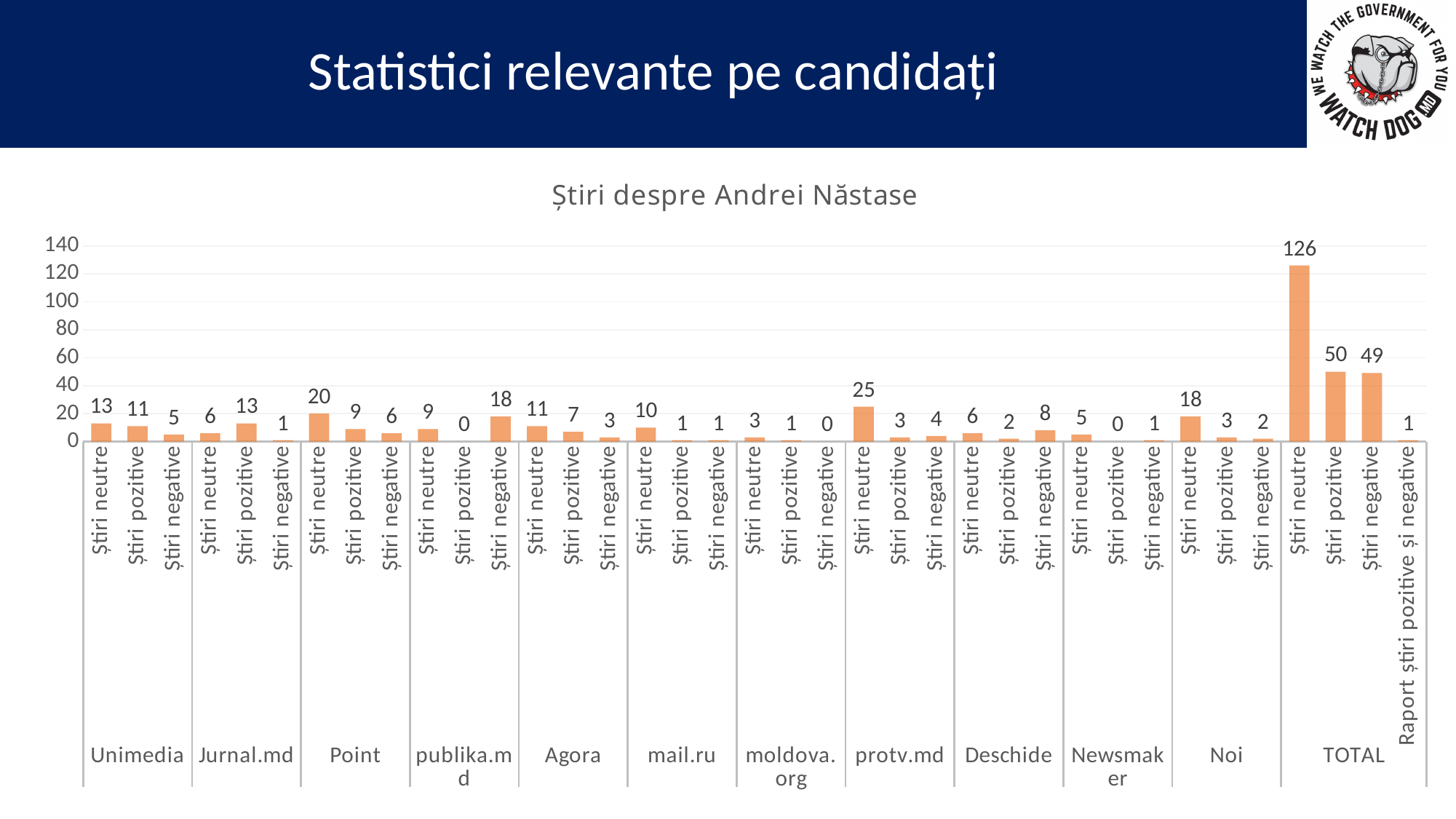
What is the value of Știri neutre for protv.md? 25 What is the title of the chart? Știri despre Andrei Năstase What kind of chart is shown on the slide? bar chart What is the difference between Știri neutre and Știri pozitive for Point? 11 What is the value of Știri pozitive in the TOTAL group? 50 What is the value of Raport știri pozitive și negative in the TOTAL group? 1 Excluding the TOTAL group, which outlet has the highest value for Știri neutre? protv.md Which bar has the highest value in the chart? Știri neutre (TOTAL) Which is larger for Deschide: Știri neutre or Știri negative? Știri negative What is the value of Știri pozitive for Jurnal.md? 13 What is the value of Știri negative for publika.md? 18 Is the value of Știri neutre in the TOTAL group greater or less than 100? greater